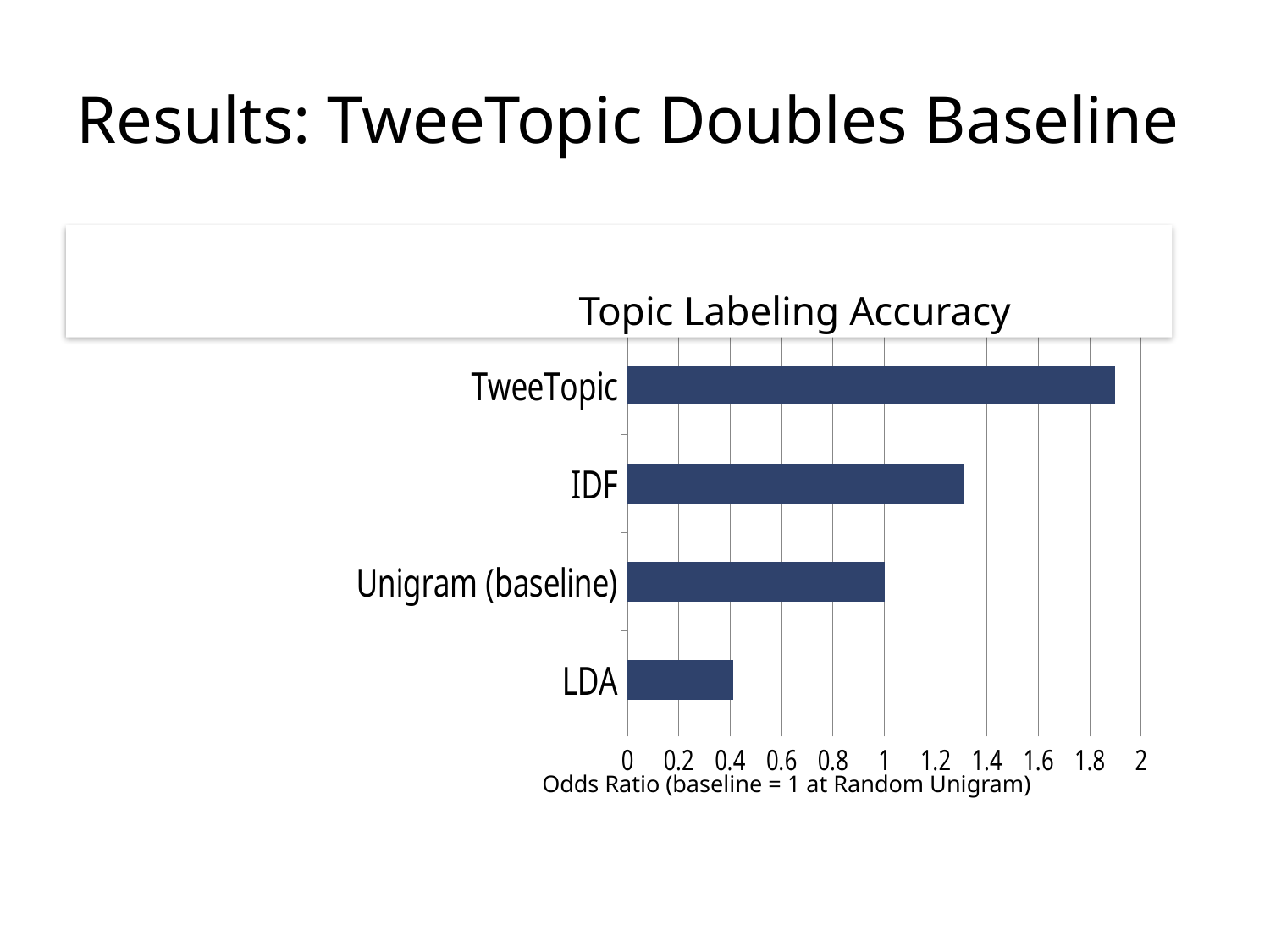
Is the value for LDA greater or less than 0.6? less Which category has the lowest odds ratio? LDA Which has a larger odds ratio, LDA or TweeTopic? TweeTopic How many categories are plotted in the chart? 4 What is the title of the chart? Topic Labeling Accuracy Which has a larger odds ratio, IDF or Unigram (baseline)? IDF Is the value for TweeTopic greater or less than 1.6? greater Is the value for IDF greater or less than 1? greater What kind of chart is shown on the slide? bar chart Which category has the highest odds ratio? TweeTopic What is the label of the horizontal axis of the chart? Odds Ratio (baseline = 1 at Random Unigram) What is the odds ratio for Unigram (baseline)? 1